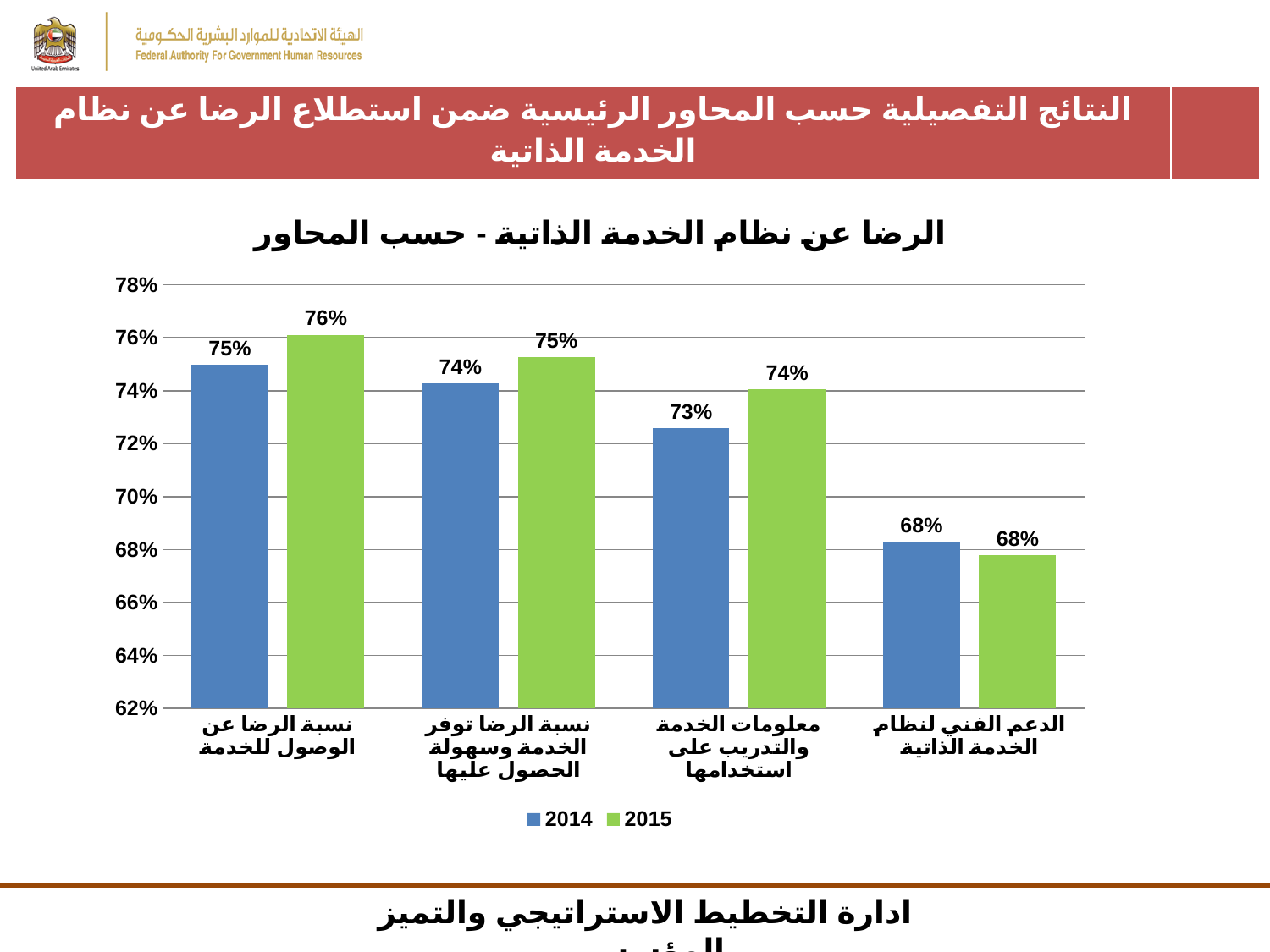
Is the 2014 value for "معلومات الخدمة والتدريب على استخدامها" greater or less than 70%? greater For "نسبة الرضا توفر الخدمة وسهولة الحصول عليها", which is larger, the 2014 value or the 2015 value? 2015 How many categories are shown on the x axis? 4 What is the difference between the 2015 and 2014 values for "معلومات الخدمة والتدريب على استخدامها"? 1% What type of chart is shown on the slide? Bar chart Which category has the highest 2015 value? نسبة الرضا عن الوصول للخدمة What is the 2014 value for "نسبة الرضا عن الوصول للخدمة"? 75% Which category has the lowest 2014 value? الدعم الفني لنظام الخدمة الذاتية What is the 2015 value for "نسبة الرضا عن الوصول للخدمة"? 76% How many series does the legend list? 2 What is the 2014 value for "الدعم الفني لنظام الخدمة الذاتية"? 68% What is the 2015 value for "معلومات الخدمة والتدريب على استخدامها"? 74%